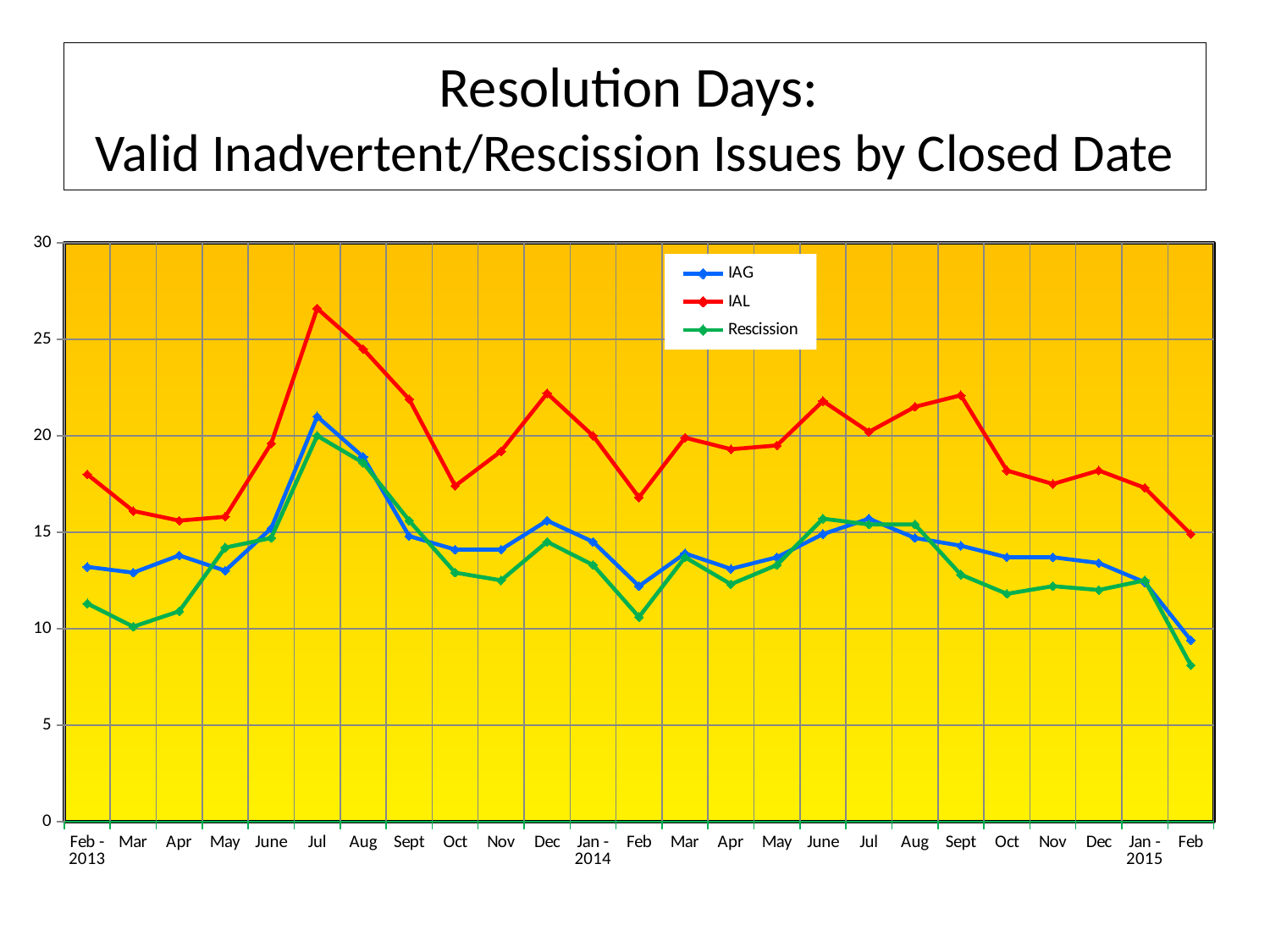
What colour is the IAL line in the chart? red In which month does the IAL series reach its highest value? Jul (2013) How many series does the legend list? 3 Is the Rescission value for Feb 2015 greater or less than 10? less What kind of chart is shown on the slide? line chart Is the IAL value for Jul 2013 greater or less than 25? greater In which month does the IAG series reach its highest value? Jul (2013) In Feb 2013, which is larger: the IAG value or the Rescission value? IAG Do the IAL values rise or fall from Jul 2013 to Oct 2013? fall In which month does the Rescission series reach its lowest value? Feb (2015) How many months (data points) are plotted along the x axis? 25 Is the IAL value for Feb 2014 greater or less than 20? less